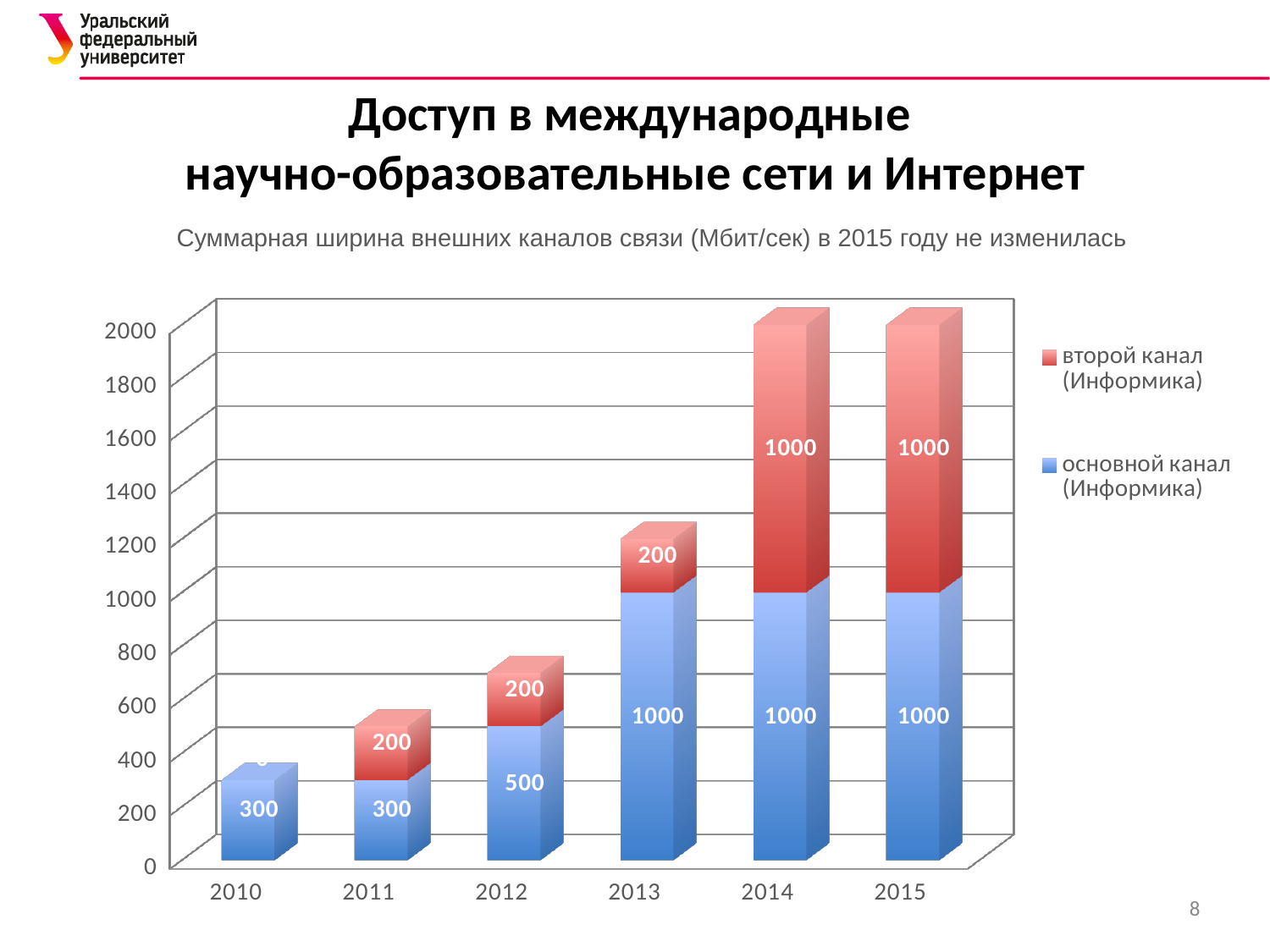
Do the total bar heights rise or fall from 2010 to 2014? rise What kind of chart is shown on the slide? stacked bar chart What is the difference between the основной канал (Информика) values for 2013 and 2012? 500 How many years are shown on the x axis? 6 How many series does the legend list? 2 What is the value of the второй канал (Информика) series for 2014? 1000 What is the value of the второй канал (Информика) series for 2013? 200 What is the value of the основной канал (Информика) series for 2010? 300 What is the value of the основной канал (Информика) series for 2012? 500 What is the total of the stacked bar for 2015? 2000 Which is larger for 2012: the основной канал (Информика) value or the второй канал (Информика) value? основной канал (Информика) What is the total of the stacked bar for 2011? 500